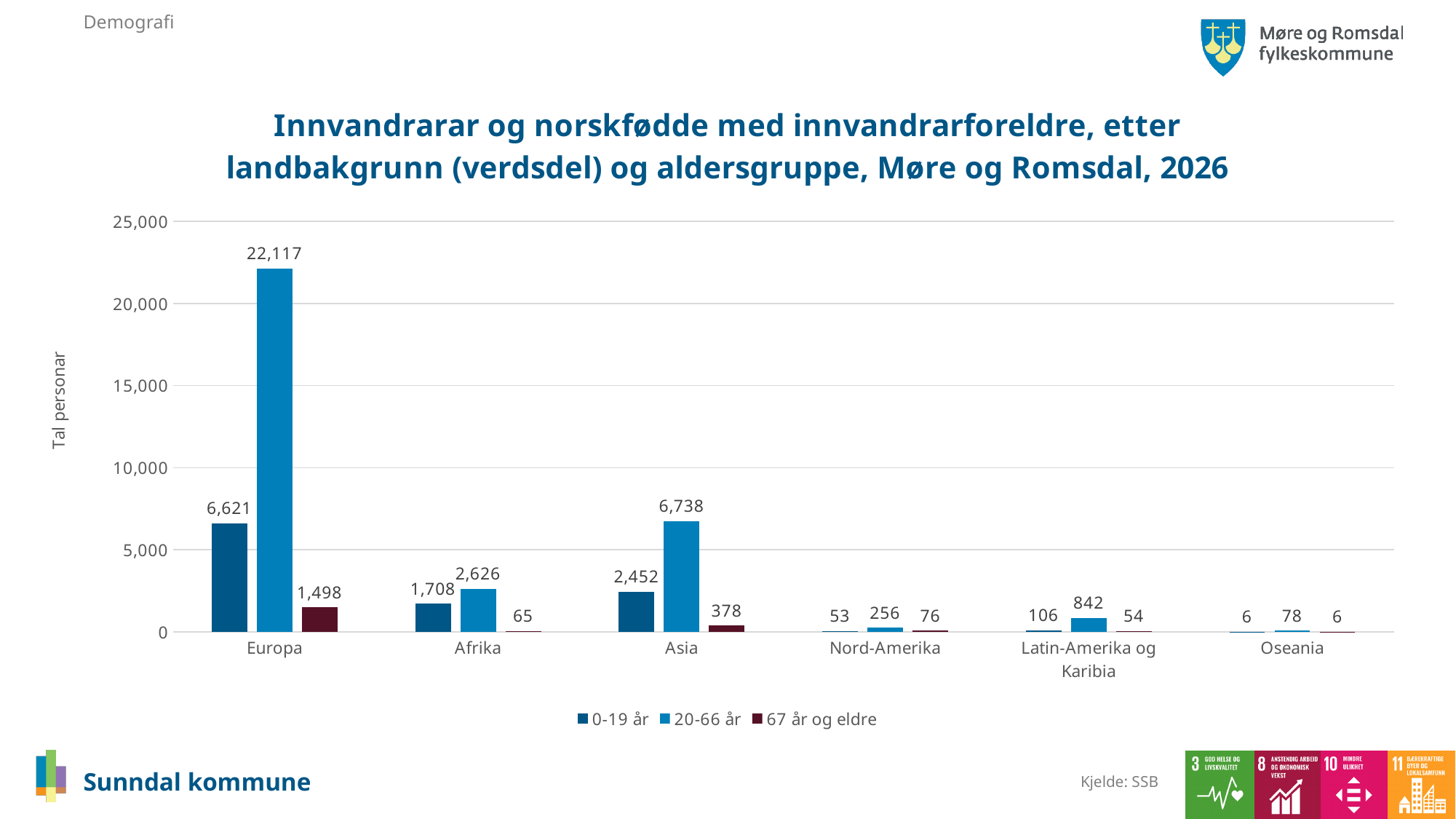
What is the value for the 20-66 år series for Europa? 22,117 How many series does the legend list? 3 How many regions are shown on the x axis? 6 What is the label of the y axis? Tal personar What kind of chart is shown on the slide? bar chart What is the value for the 0-19 år series for Latin-Amerika og Karibia? 106 Is the 20-66 år value for Europa greater or less than 20,000? greater What is the difference between the 20-66 år values for Asia and Afrika? 4,112 Which region has the highest value for the 20-66 år series? Europa Which is larger: the 0-19 år value for Asia or the 0-19 år value for Afrika? Asia Which region has the lowest value for the 0-19 år series? Oseania What is the value for the 67 år og eldre series for Asia? 378